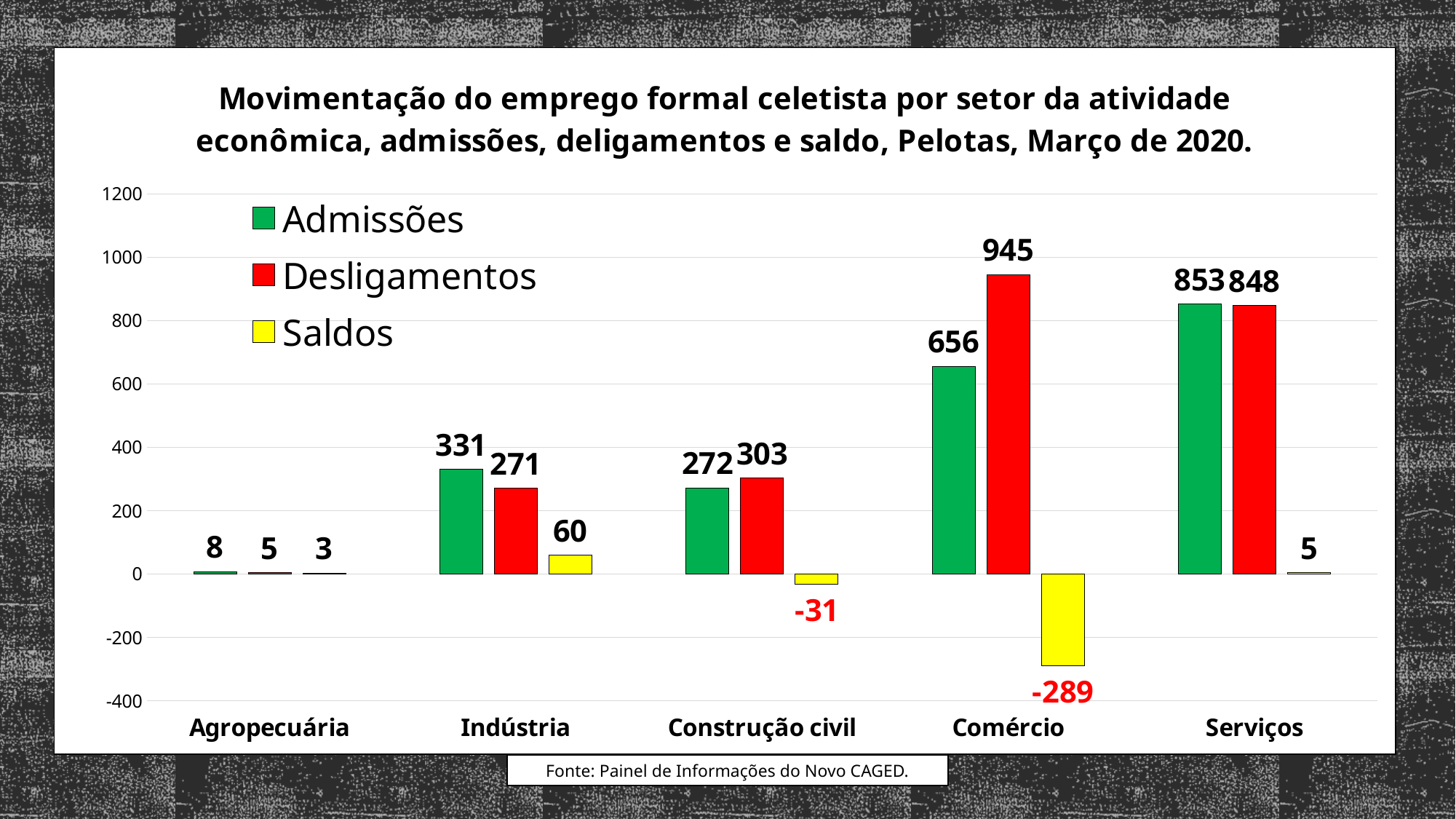
How many series does the legend list? 3 What is the Desligamentos value for Indústria? 271 Which sector has the lowest Saldos value? Comércio How many sectors are shown on the x axis? 5 Which sector has the lowest Admissões value? Agropecuária What is the Saldos value for Construção civil? -31 What is the difference between Admissões and Desligamentos for Serviços? 5 What kind of chart is shown on the slide? Bar chart What is the Admissões value for Comércio? 656 Which is larger for Construção civil, Admissões or Desligamentos? Desligamentos Which sector has the highest Desligamentos value? Comércio What colour represents the Saldos series in the legend? Yellow